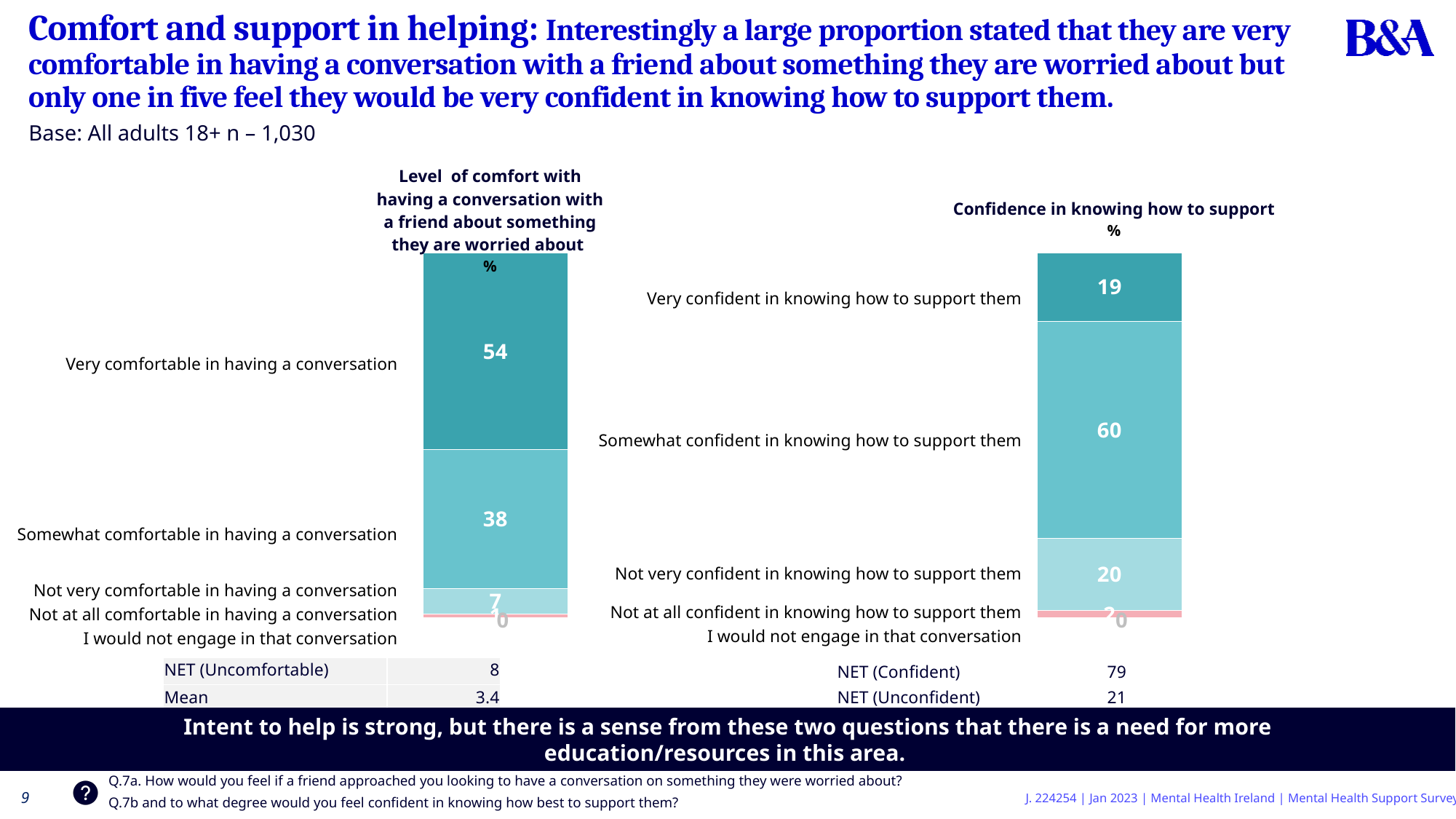
In the right chart on confidence in knowing how to support, what percentage are not very confident in knowing how to support them? 20 In the right chart on confidence in knowing how to support, which response has the largest segment? Somewhat confident in knowing how to support them In the left chart on level of comfort, what percentage are very comfortable in having a conversation? 54 In the left chart on level of comfort, what percentage are somewhat comfortable in having a conversation? 38 In the left chart on level of comfort, what percentage are not very comfortable in having a conversation? 7 In the right chart on confidence in knowing how to support, what percentage are somewhat confident in knowing how to support them? 60 Which is larger: 'Somewhat comfortable in having a conversation' in the left chart or 'Somewhat confident in knowing how to support them' in the right chart? Somewhat confident in knowing how to support them In the right chart on confidence in knowing how to support, what percentage are very confident in knowing how to support them? 19 In the left chart on level of comfort, which response has the largest segment? Very comfortable in having a conversation What type of chart is used for the confidence in knowing how to support data on the right? Stacked bar chart How much larger is the 'Very comfortable in having a conversation' value in the left chart than the 'Very confident in knowing how to support them' value in the right chart? 35 In the right chart on confidence in knowing how to support, what percentage are not at all confident in knowing how to support them? 2